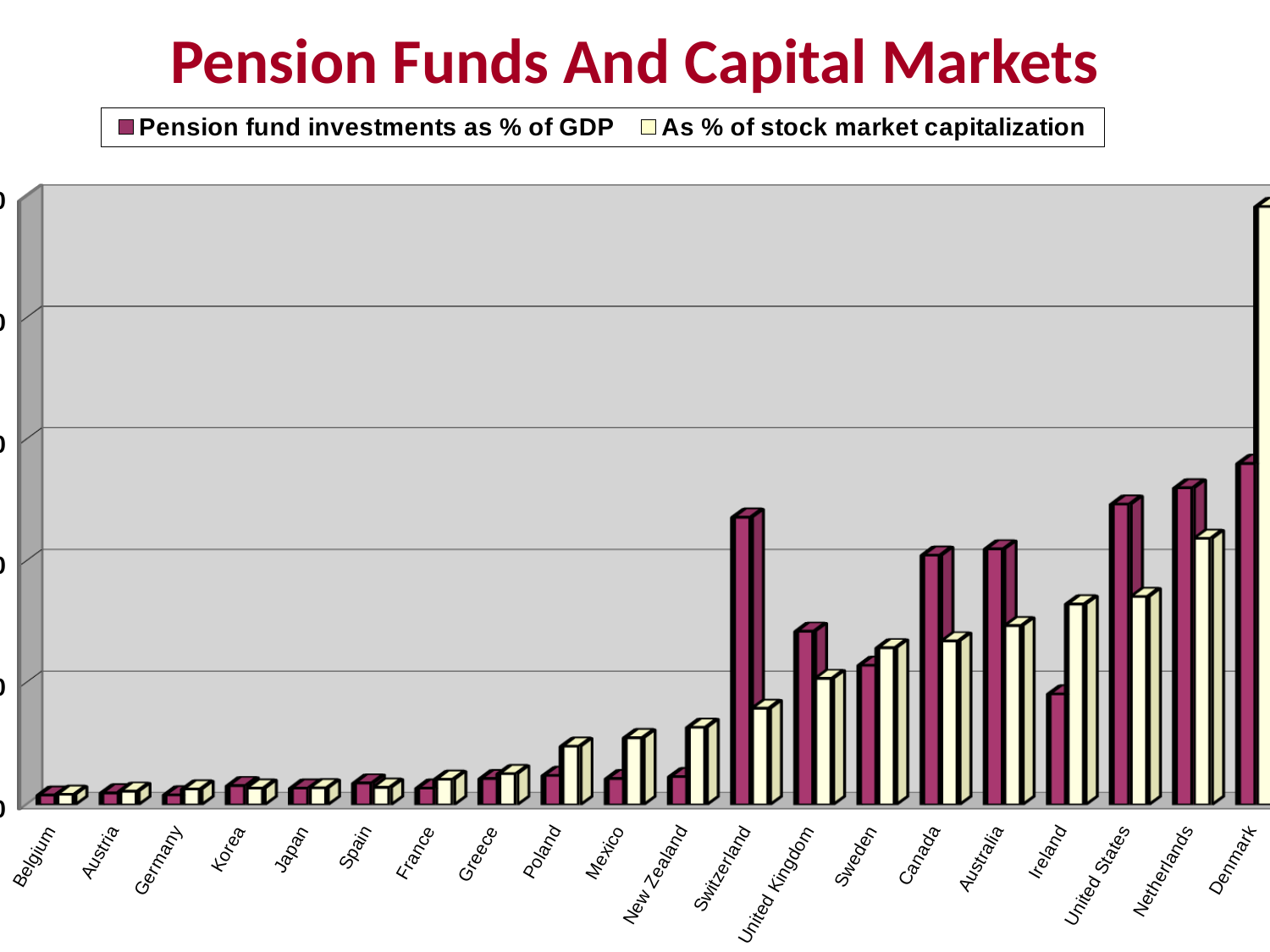
Do the values generally rise or fall moving from left to right along the x axis? Rise Which country has the highest value for 'Pension fund investments as % of GDP'? Denmark Which has the larger 'Pension fund investments as % of GDP' value, Denmark or Netherlands? Denmark What is the title of the slide? Pension Funds And Capital Markets Which has the larger 'Pension fund investments as % of GDP' value, Switzerland or United Kingdom? Switzerland What kind of chart is shown on the slide? Bar chart How many series does the legend list? 2 For Ireland, which is larger: 'Pension fund investments as % of GDP' or 'As % of stock market capitalization'? As % of stock market capitalization Which country has the highest value for 'As % of stock market capitalization'? Denmark How many countries are shown on the x axis? 20 What colour are the bars for 'As % of stock market capitalization'? Pale yellow